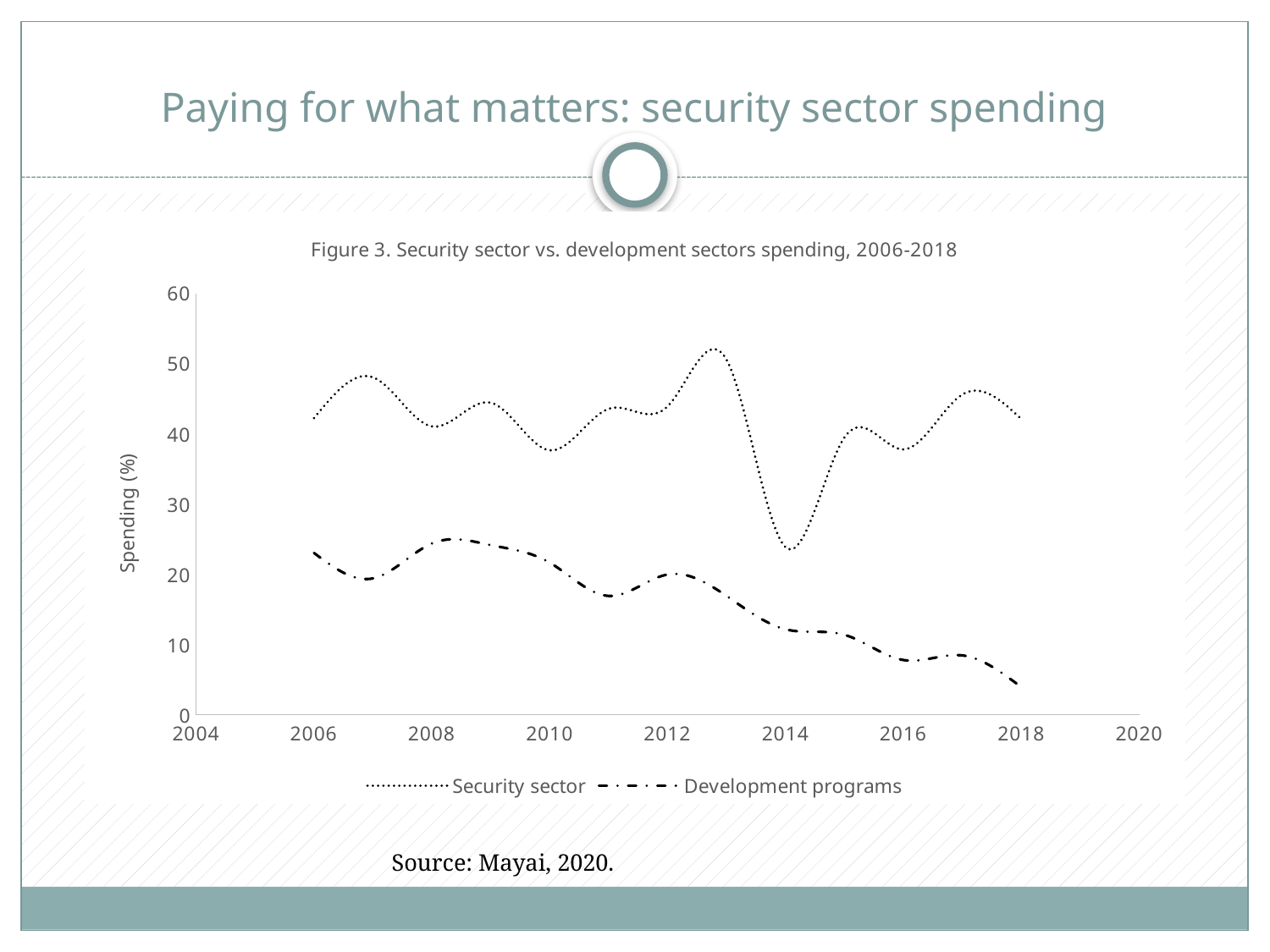
Is the Development programs value in 2008 greater or less than 20? greater In which year does the Security sector series reach its highest value? 2013 How many series does the legend list? 2 Is the Development programs value in 2018 greater or less than 10? less What is the label on the vertical axis? Spending (%) What is the title of the chart? Figure 3. Security sector vs. development sectors spending, 2006-2018 Is the Security sector value in 2014 greater or less than 30? less In which year does the Security sector series reach its lowest value? 2014 Which series has the higher value in 2014, Security sector or Development programs? Security sector What kind of chart is shown on the slide? Line chart Does the Development programs series generally rise or fall from 2006 to 2018? Fall